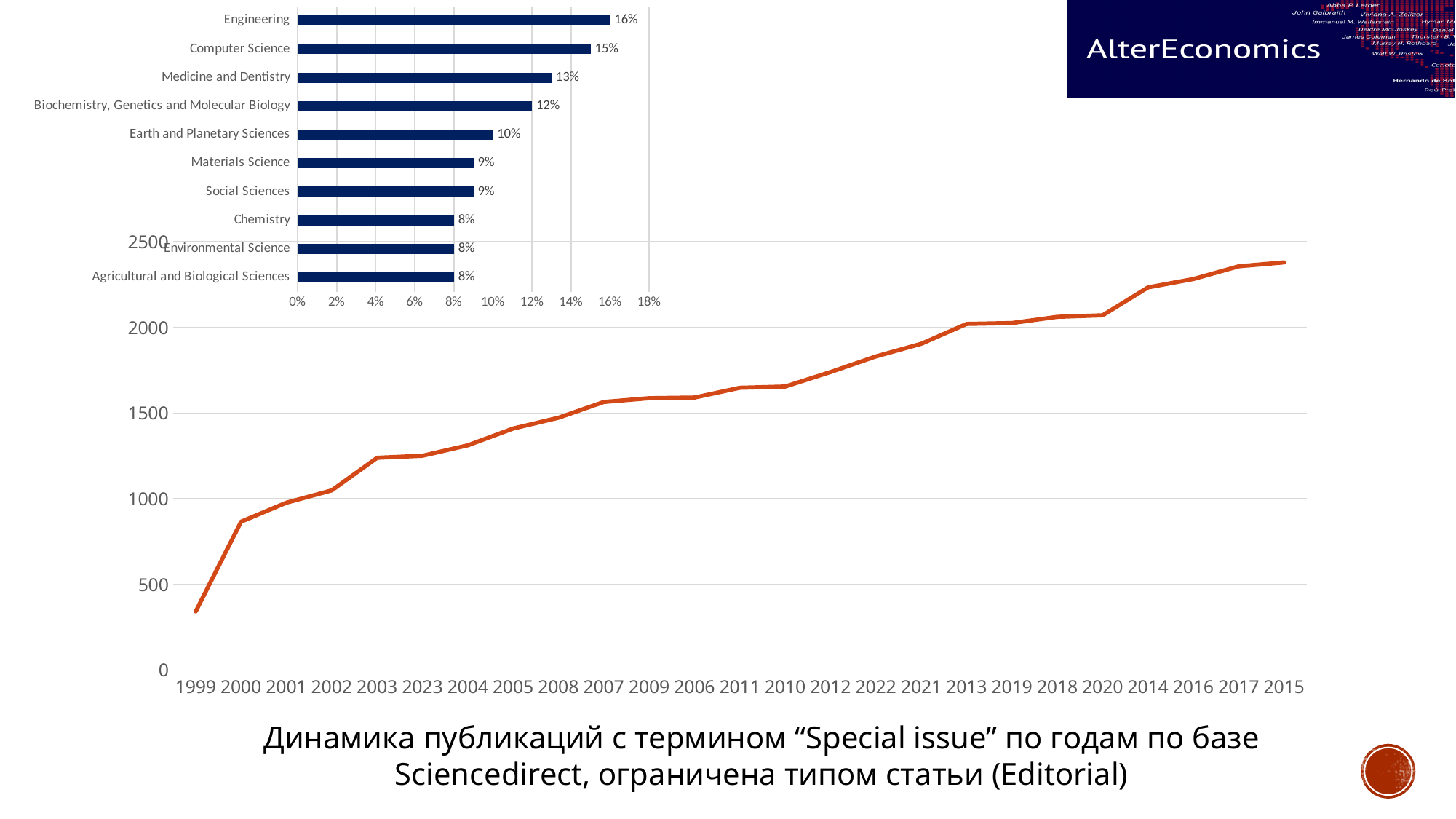
In the bar chart at the top left, which is larger, Medicine and Dentistry or Materials Science? Medicine and Dentistry How many categories does the bar chart at the top left show? 10 In the bar chart at the top left, what is the difference between Computer Science and Chemistry? 7% In the line chart of publications with the term "Special issue", is the value for 1999 greater or less than 500? less In the line chart of publications with the term "Special issue", is the value for 2015 greater or less than 2000? greater In the bar chart at the top left, what is the value for Earth and Planetary Sciences? 10% What kind of chart is the chart at the top left of the slide? bar chart In the line chart of publications with the term "Special issue", is the value for 2003 greater or less than 1000? greater What kind of chart is the large chart with years on the x axis? line chart In the bar chart at the top left, what is the value for Engineering? 16% In the bar chart at the top left, which category has the highest value? Engineering In the line chart of publications with the term "Special issue", do the values rise or fall along the x axis? rise